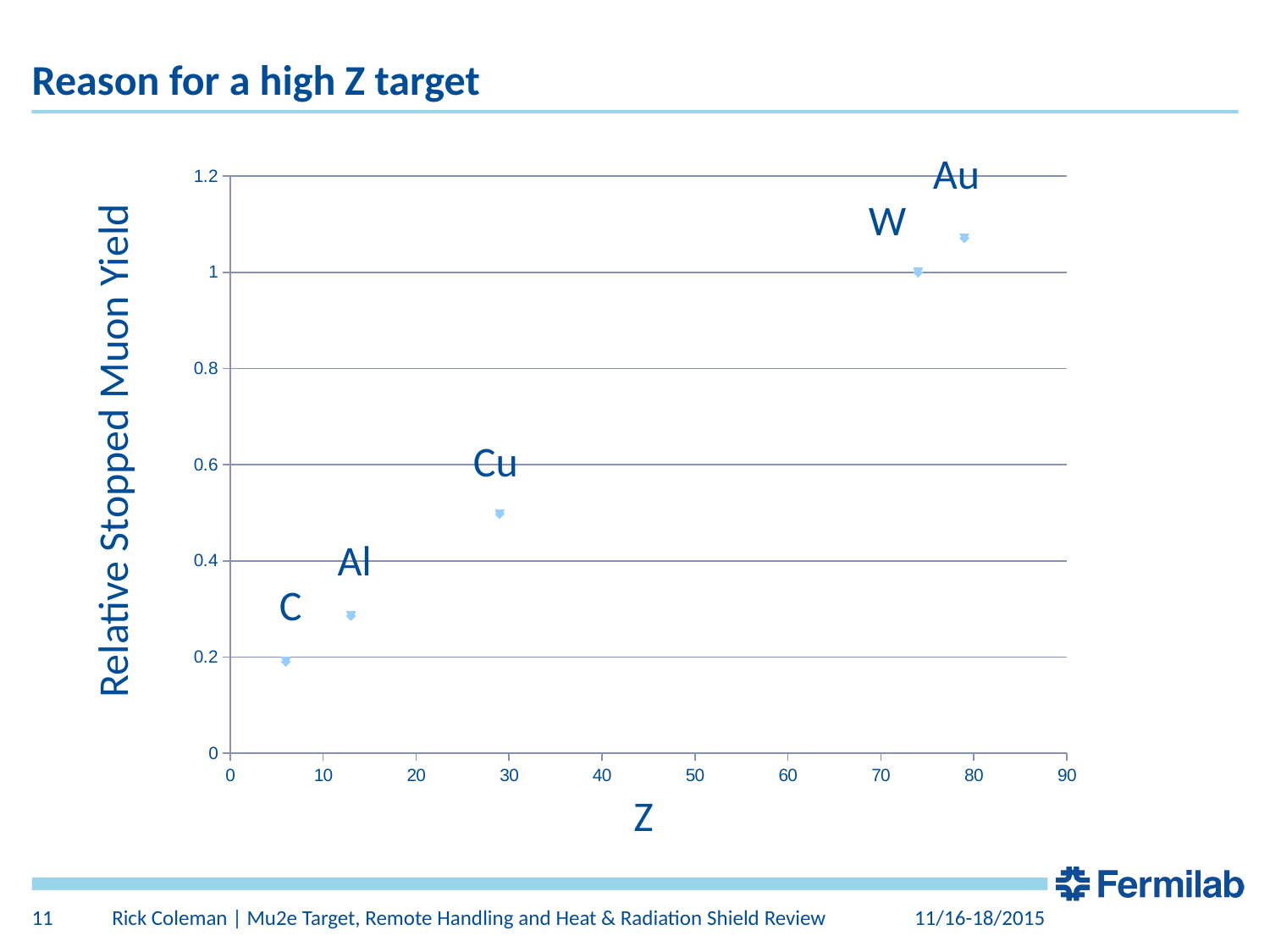
What is the relative stopped muon yield for W? 1 Which element has the lowest relative stopped muon yield? C Is the relative stopped muon yield for Al greater or less than 0.4? less How many data points are plotted on the chart? 5 Does the relative stopped muon yield rise or fall as Z increases? rises What kind of chart is shown on the slide? scatter chart Is the relative stopped muon yield for Cu greater or less than 0.6? less Is the relative stopped muon yield for Au greater or less than 1? greater What is the label of the x axis? Z Which has a higher relative stopped muon yield, Cu or Al? Cu Which element has the highest relative stopped muon yield? Au